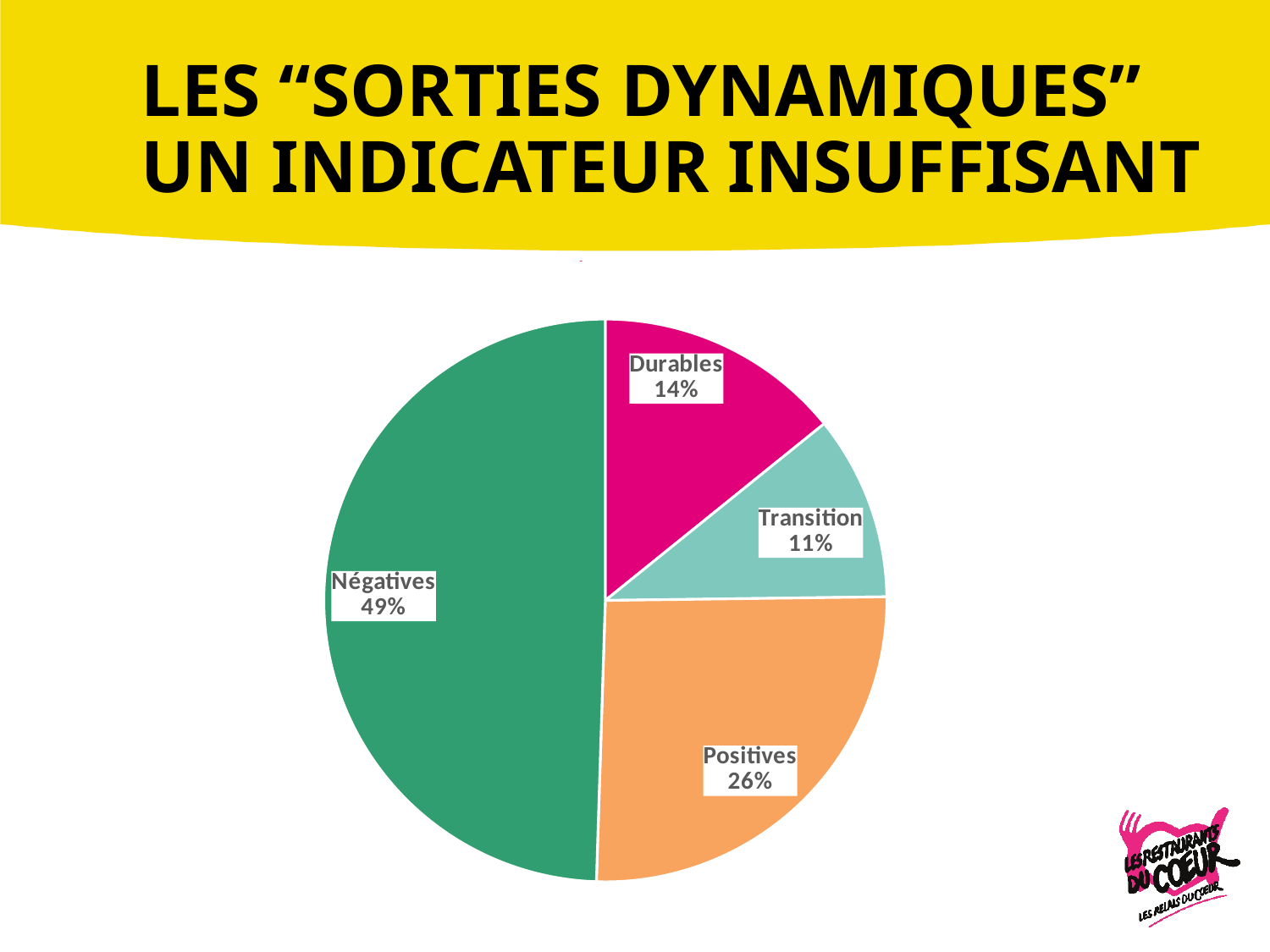
What kind of chart is shown on the slide? pie chart Which category has the largest slice of the pie? Négatives What is the value shown for Durables? 14% What is the difference between the Durables and Transition shares? 3% What is the difference between the Négatives and Positives shares? 23% What colour is the Négatives slice? green Which category has the smallest slice of the pie? Transition What is the value shown for Transition? 11% What is the value shown for Positives? 26% How many slices does the pie chart have? 4 Which is larger, the Positives slice or the Durables slice? Positives What share of the pie does the Négatives slice represent? 49%